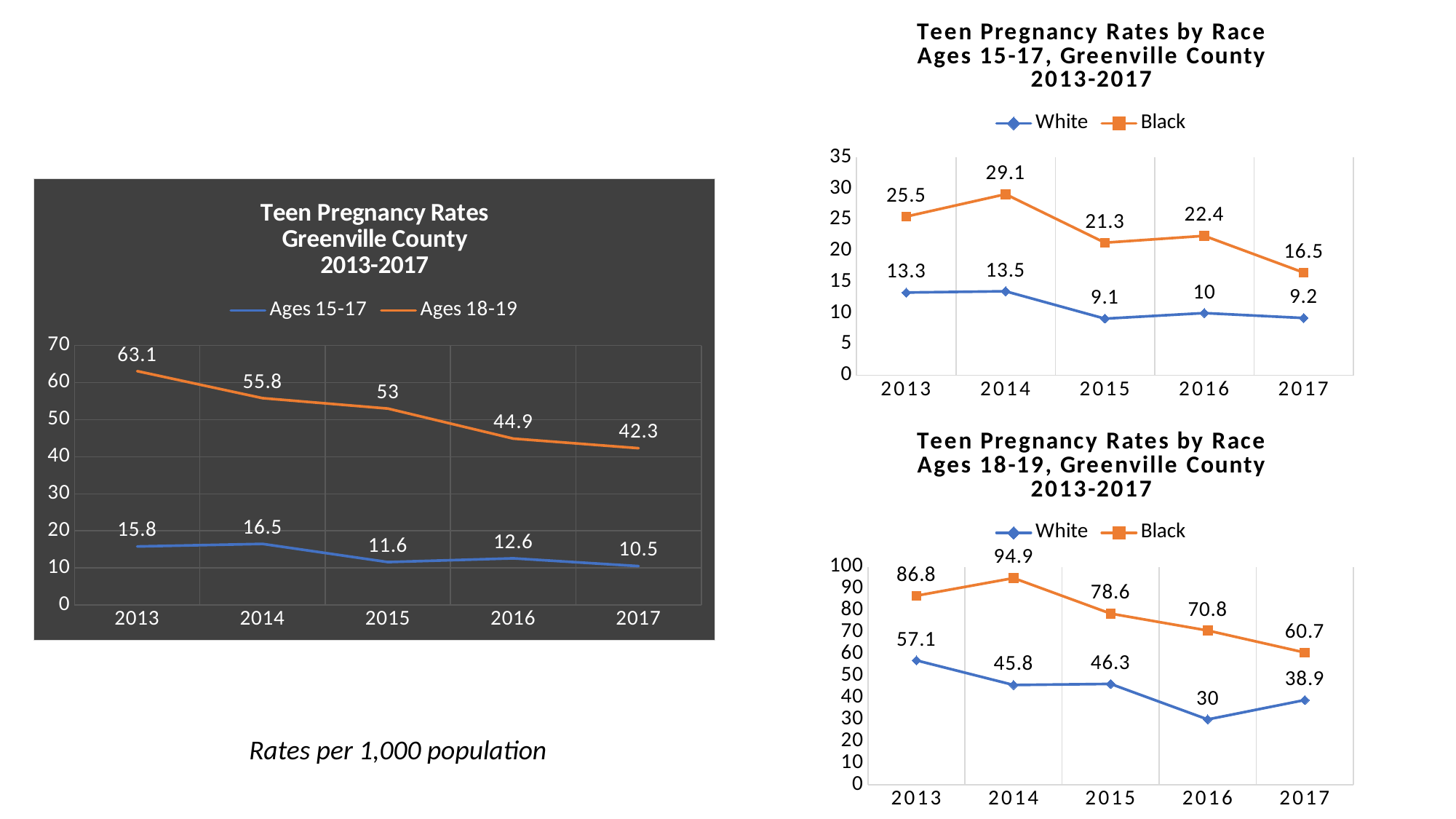
In the 'Teen Pregnancy Rates by Race Ages 15-17' chart at the top right, how many series does the legend list? 2 In the 'Teen Pregnancy Rates by Race Ages 18-19' chart at the bottom right, how many years are shown on the x axis? 5 In the 'Teen Pregnancy Rates Greenville County 2013-2017' chart on the left, in which year is the Ages 15-17 value highest? 2014 In the 'Teen Pregnancy Rates Greenville County 2013-2017' chart on the left, what is the value for Ages 15-17 in 2017? 10.5 In the 'Teen Pregnancy Rates Greenville County 2013-2017' chart on the left, what is the difference between the Ages 18-19 and Ages 15-17 values in 2015? 41.4 In the 'Teen Pregnancy Rates Greenville County 2013-2017' chart on the left, what kind of chart is it? Line chart In the 'Teen Pregnancy Rates by Race Ages 18-19' chart at the bottom right, what is the value for White in 2016? 30 In the 'Teen Pregnancy Rates by Race Ages 18-19' chart at the bottom right, what is the difference between the Black and White values in 2017? 21.8 In the 'Teen Pregnancy Rates by Race Ages 15-17' chart at the top right, in which year is the White value lowest? 2015 In the 'Teen Pregnancy Rates Greenville County 2013-2017' chart on the left, what is the value for Ages 18-19 in 2013? 63.1 In the 'Teen Pregnancy Rates by Race Ages 15-17' chart at the top right, what is the value for Black in 2014? 29.1 In the 'Teen Pregnancy Rates by Race Ages 18-19' chart at the bottom right, which is larger in 2013: the White value or the Black value? Black